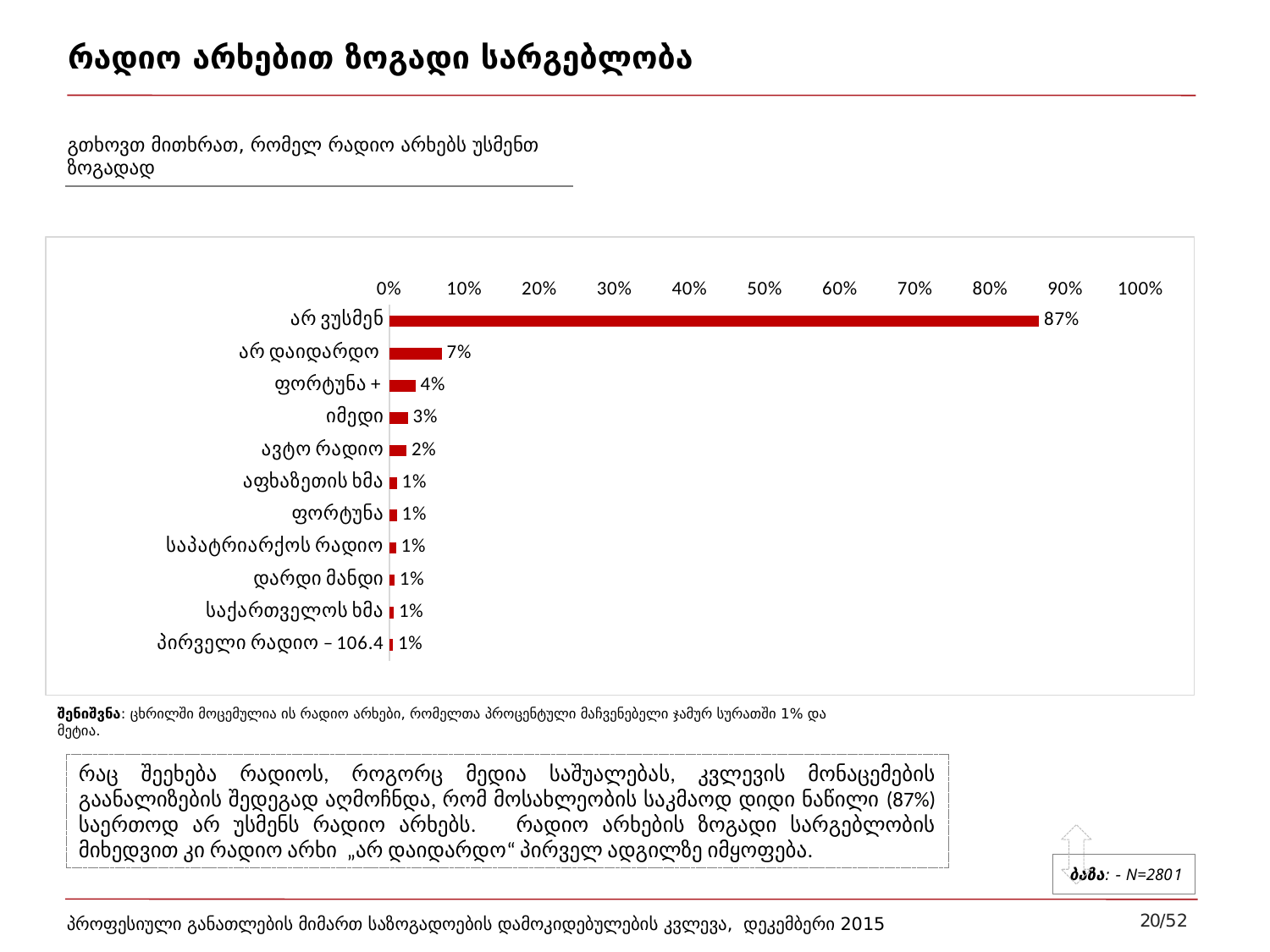
Which is larger, the value for "ფორტუნა +" or the value for "იმედი"? ფორტუნა + What is the value for "იმედი"? 3% What is the value for "ფორტუნა +"? 4% What kind of chart is shown on the slide? bar chart What is the difference between the values for "არ ვუსმენ" and "არ დაიდარდო"? 80% What is the highest value shown on the percentage axis of the chart? 100% What is the value for "არ ვუსმენ"? 87% Is the value for "არ ვუსმენ" greater or less than 80%? greater What is the value for "არ დაიდარდო"? 7% How many categories are shown in the chart? 11 Which category has the highest value? არ ვუსმენ What is the value for "ავტო რადიო"? 2%